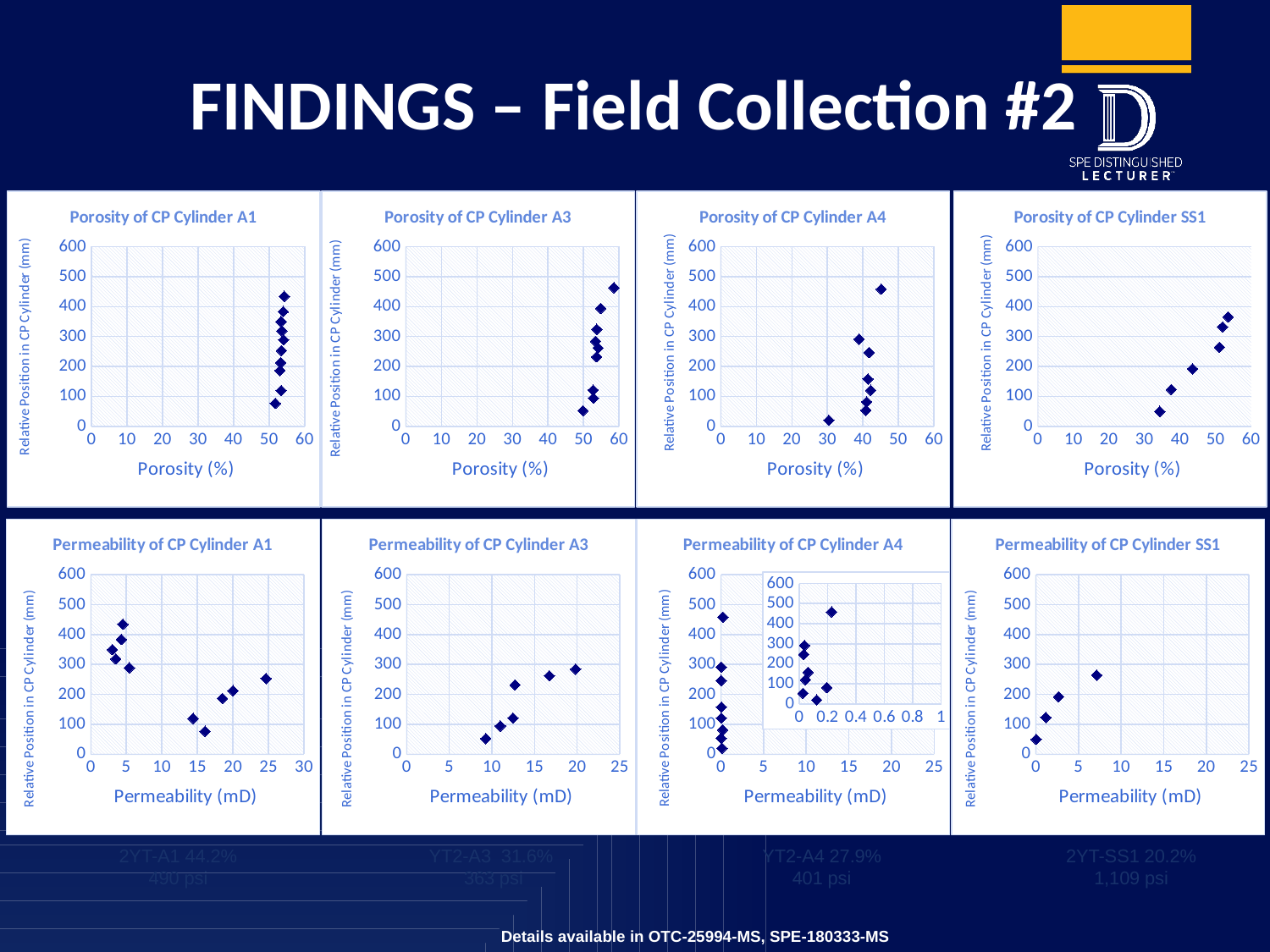
In the "Porosity of CP Cylinder SS1" chart, does relative position rise or fall as porosity increases? rise How many charts are shown on the slide? 9 In the "Porosity of CP Cylinder A1" chart, are the porosity values of the points greater or less than 50? greater In the "Porosity of CP Cylinder A4" chart, is the porosity of the highest point (near 450 mm) greater or less than 40? greater In the "Porosity of CP Cylinder SS1" chart, is the porosity of the lowest point (nearest 0 mm) greater or less than 40? less What is the y-axis title of the "Porosity of CP Cylinder SS1" chart? Relative Position in CP Cylinder (mm) What is the x-axis title of the "Permeability of CP Cylinder A3" chart? Permeability (mD) In the "Permeability of CP Cylinder A3" chart, does relative position rise or fall as permeability increases? rise What is the maximum value shown on the x axis of the "Permeability of CP Cylinder A1" chart? 30 What kind of chart is "Porosity of CP Cylinder A1"? Scatter chart